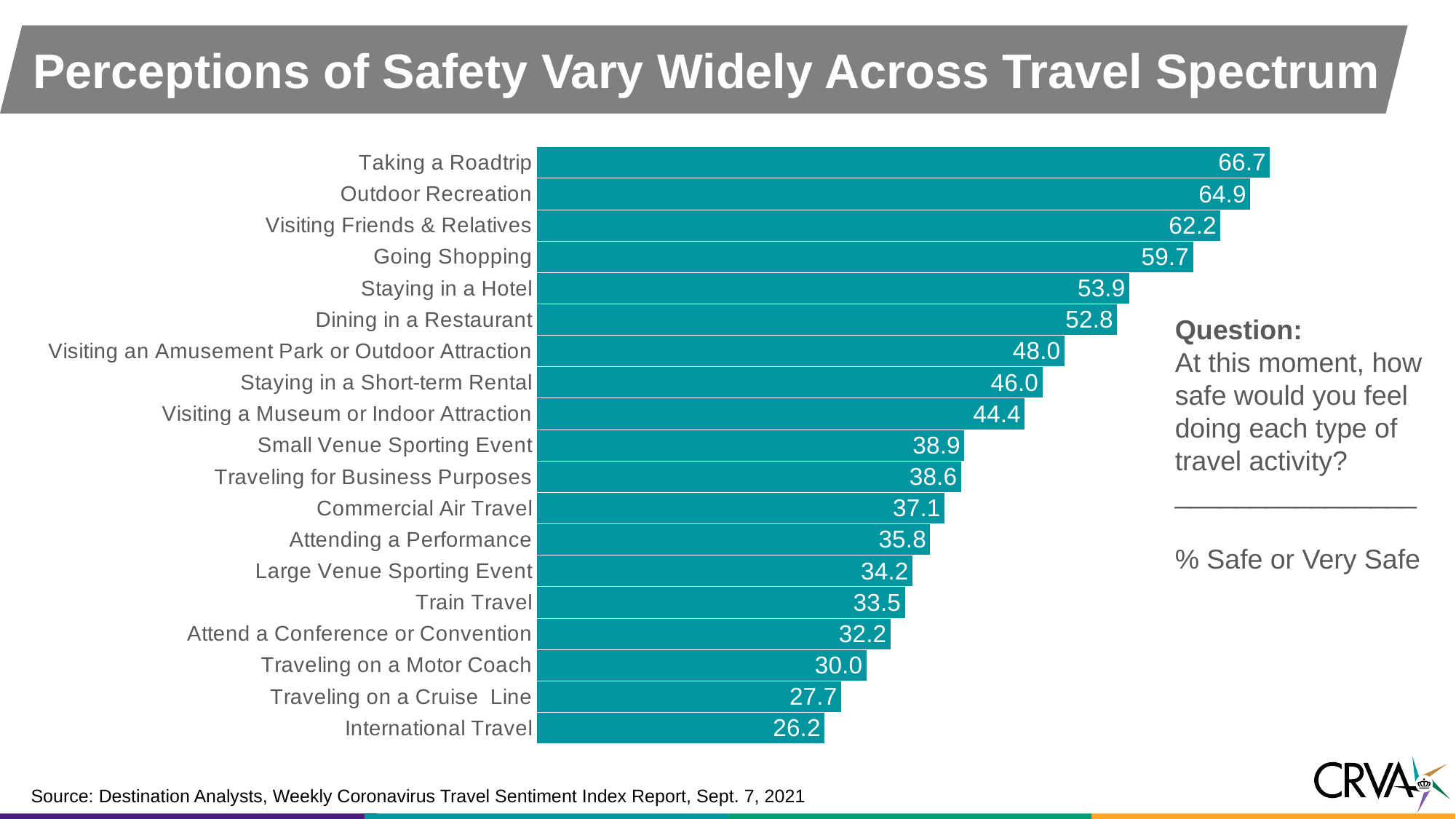
What is the difference between the values for Taking a Roadtrip and International Travel? 40.5 What is the value for Traveling on a Cruise Line? 27.7 What kind of chart is shown on the slide? Bar chart What is the value for Staying in a Hotel? 53.9 How many activities are shown in the chart? 19 What is the value for Commercial Air Travel? 37.1 What is the difference between the values for Going Shopping and Staying in a Hotel? 5.8 What is the value for Traveling on a Motor Coach? 30.0 What measure do the bar values represent, according to the text on the slide? % Safe or Very Safe Which activity has the lowest value? International Travel Which is larger, the value for Visiting a Museum or Indoor Attraction or the value for Small Venue Sporting Event? Visiting a Museum or Indoor Attraction Which activity has the highest value? Taking a Roadtrip